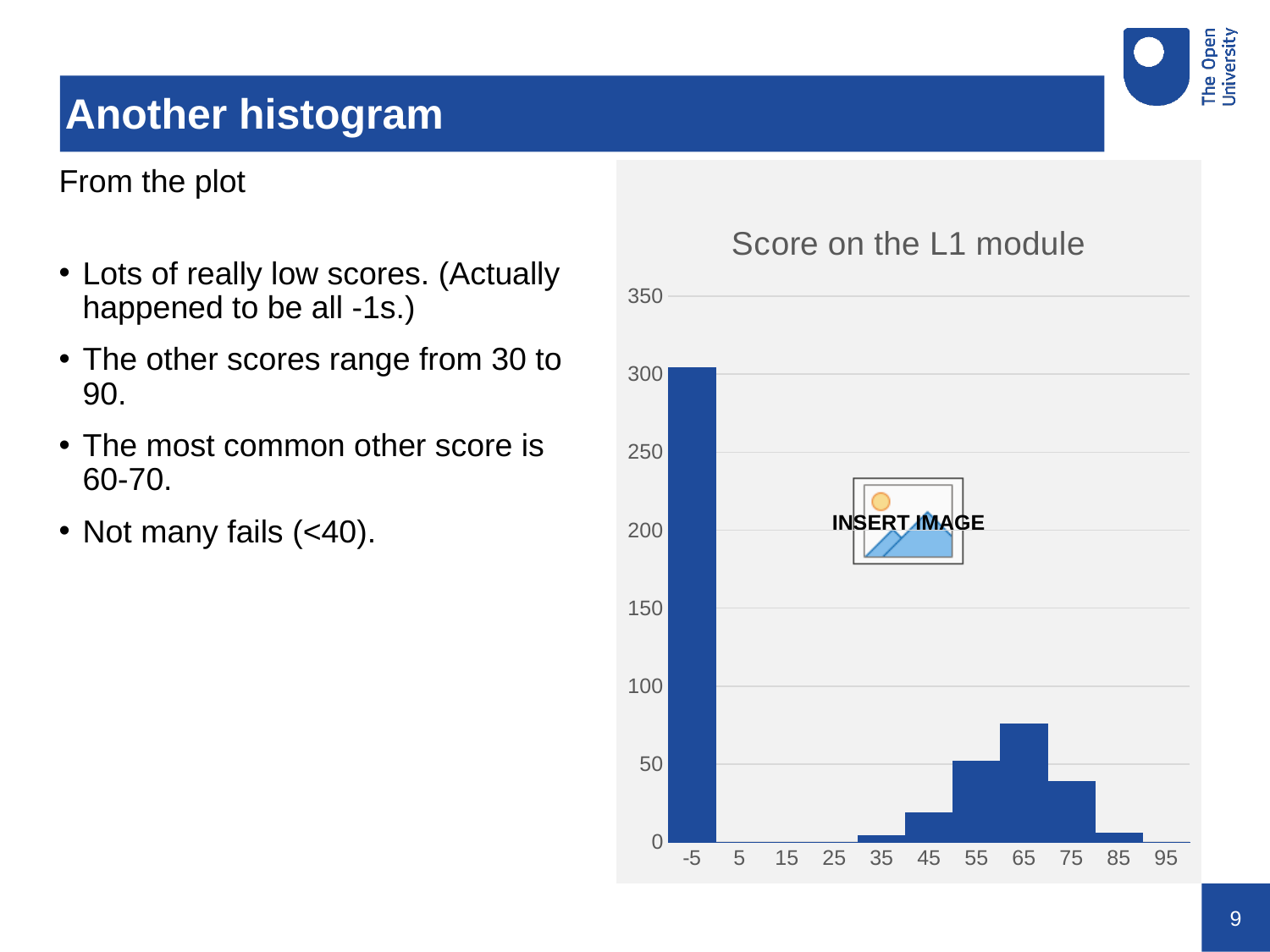
What is the title of the chart? Score on the L1 module What kind of chart is shown on the slide? bar chart Which x-axis bin has the tallest bar? -5 Is the value for the 45 bin greater or less than 50? less How many tick labels are shown on the x axis? 11 Is the value for the -5 bin greater or less than 250? greater Is the value for the 65 bin greater or less than 50? greater Which bar is taller, the 45 bin or the 55 bin? 55 Which bar is taller, the 65 bin or the 75 bin? 65 What is the highest value labelled on the y axis? 350